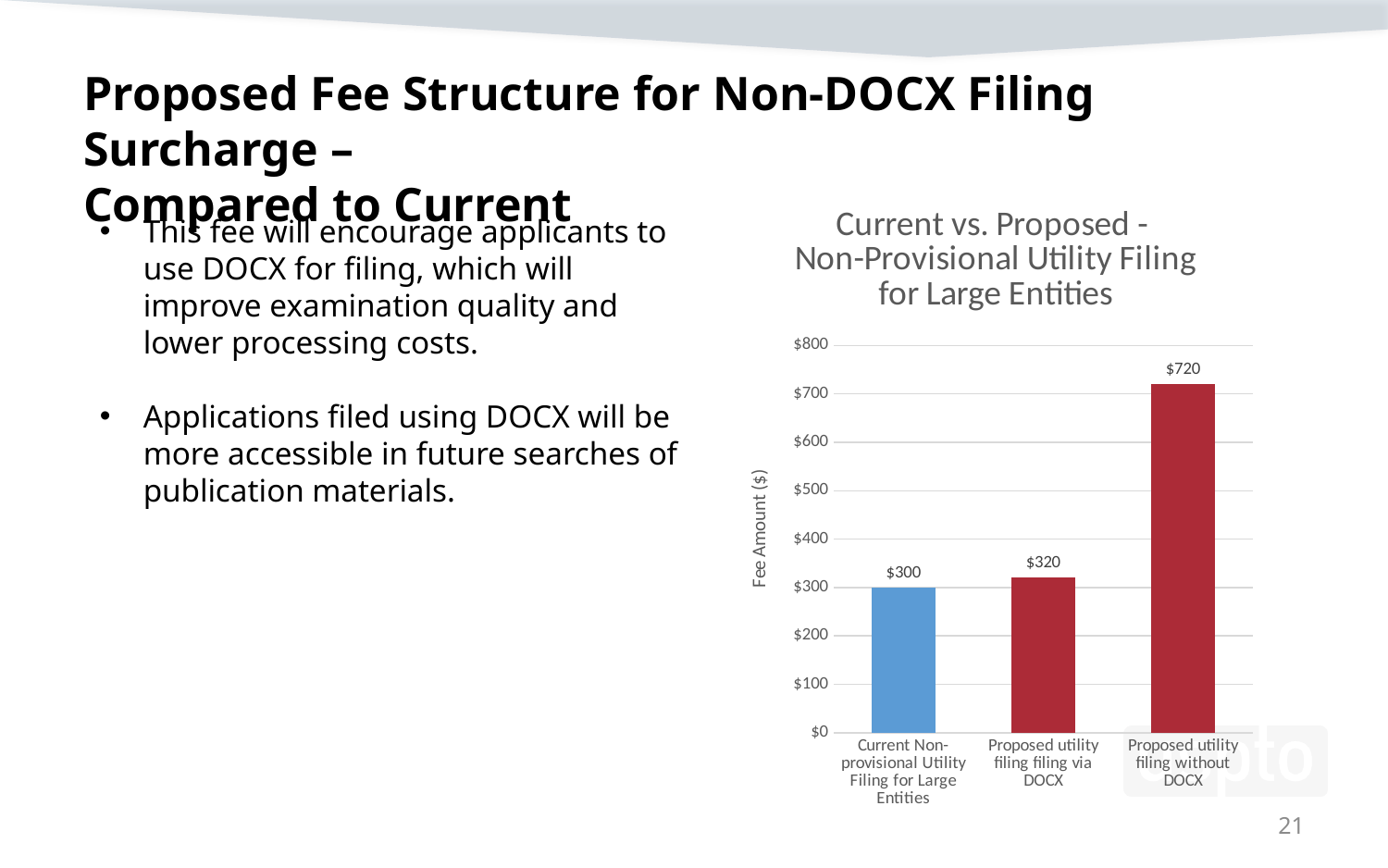
Which category has the lowest fee amount? Current Non-provisional Utility Filing for Large Entities How many categories are shown on the chart? 3 What is the difference between the fee for Proposed utility filing filing via DOCX and the Current Non-provisional Utility Filing for Large Entities fee? $20 Is the value for Proposed utility filing without DOCX greater or less than $600? greater Which category has the highest fee amount? Proposed utility filing without DOCX What kind of chart is shown on the slide? Bar chart What is the difference between the fee for Proposed utility filing without DOCX and the fee for Proposed utility filing filing via DOCX? $400 What is the fee amount for Proposed utility filing without DOCX? $720 What is the fee amount for Proposed utility filing filing via DOCX? $320 What is the title of the chart? Current vs. Proposed - Non-Provisional Utility Filing for Large Entities Which is larger: the fee for Proposed utility filing without DOCX or the Current Non-provisional Utility Filing for Large Entities fee? Proposed utility filing without DOCX What is the fee amount for Current Non-provisional Utility Filing for Large Entities? $300